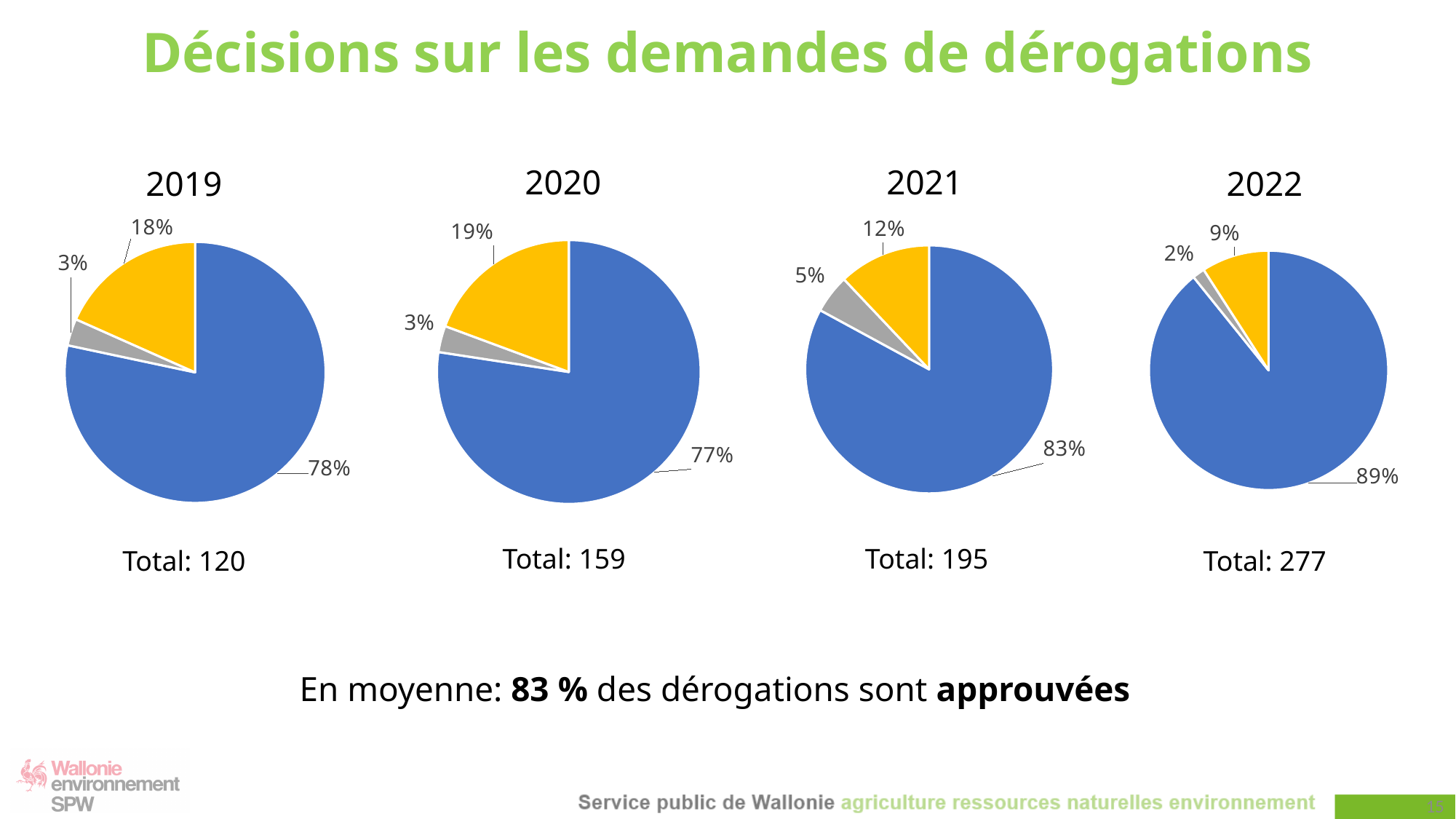
In the 2021 pie chart, what share does the grey slice represent? 5% What kind of charts are shown on the slide? Pie charts Which pie chart has the smallest yellow slice? 2022 What is the difference between the blue slice in the 2022 pie chart and the blue slice in the 2019 pie chart? 11% Which pie chart has the largest blue slice? 2022 How many pie charts are on the slide? 4 What total is shown under the 2022 pie chart? Total: 277 How many slices does the 2021 pie chart have? 3 In the 2020 pie chart, what share does the yellow slice represent? 19% In the 2022 pie chart, what share does the blue slice represent? 89% In the 2019 pie chart, what share does the blue slice represent? 78% Is the yellow slice larger in the 2020 pie chart or in the 2021 pie chart? 2020